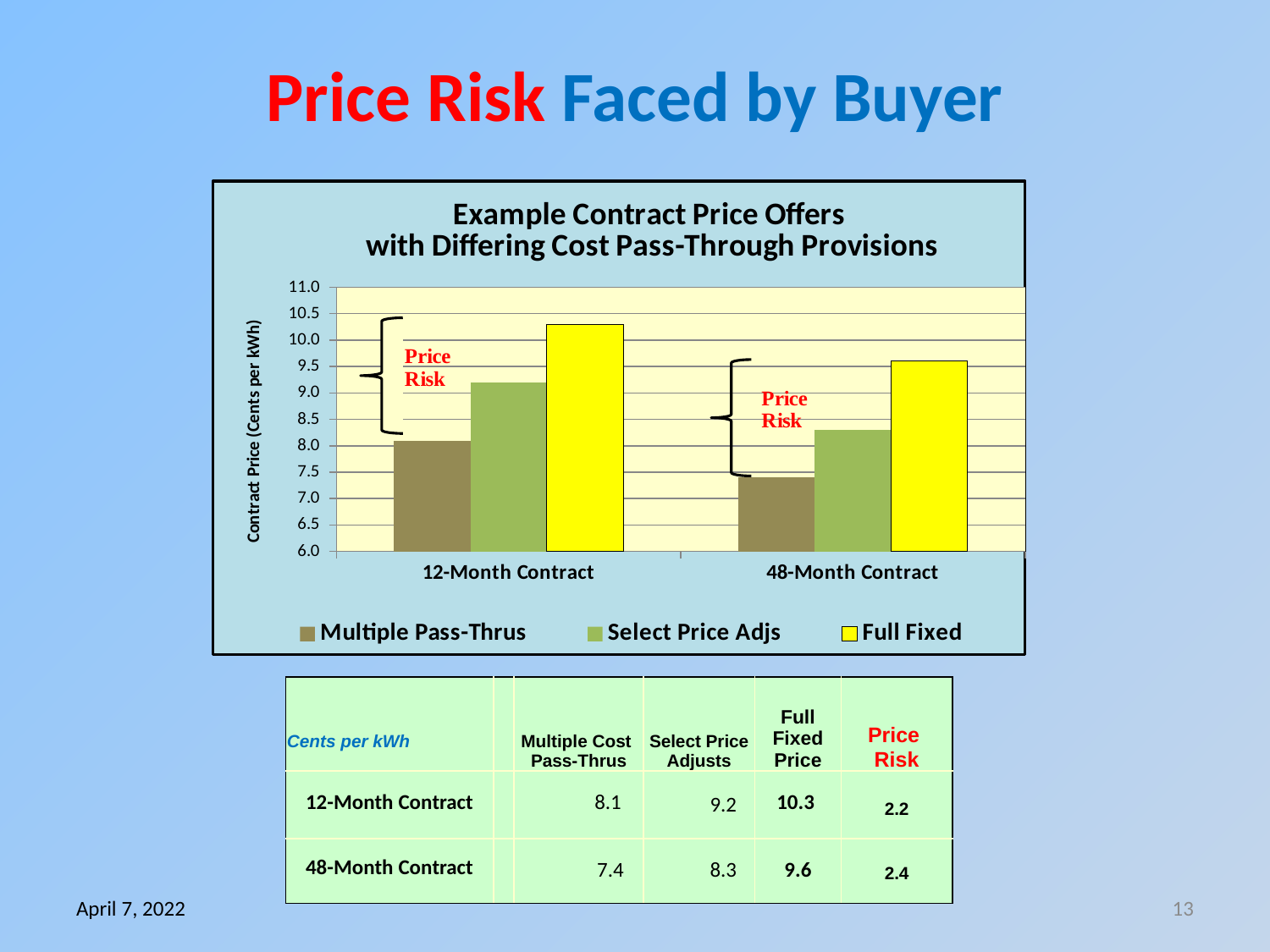
How many series does the chart legend list? 3 What is the Multiple Pass-Thrus contract price for the 48-Month Contract, in cents per kWh? 7.4 What type of chart is shown on the slide? bar chart What is the Select Price Adjs contract price for the 12-Month Contract, in cents per kWh? 9.2 Is the Select Price Adjs value for the 48-Month Contract greater or less than 9.0? less How many contract categories are shown on the x axis of the chart? 2 Is the Full Fixed price for the 12-Month Contract or the 48-Month Contract larger? 12-Month Contract Which series has the lowest contract price for the 12-Month Contract? Multiple Pass-Thrus Which series has the highest contract price for the 48-Month Contract? Full Fixed What is the difference between the Full Fixed price and the Multiple Pass-Thrus price for the 48-Month Contract, in cents per kWh? 2.2 What is the Full Fixed contract price for the 12-Month Contract, in cents per kWh? 10.3 What is the title of the chart? Example Contract Price Offers with Differing Cost Pass-Through Provisions